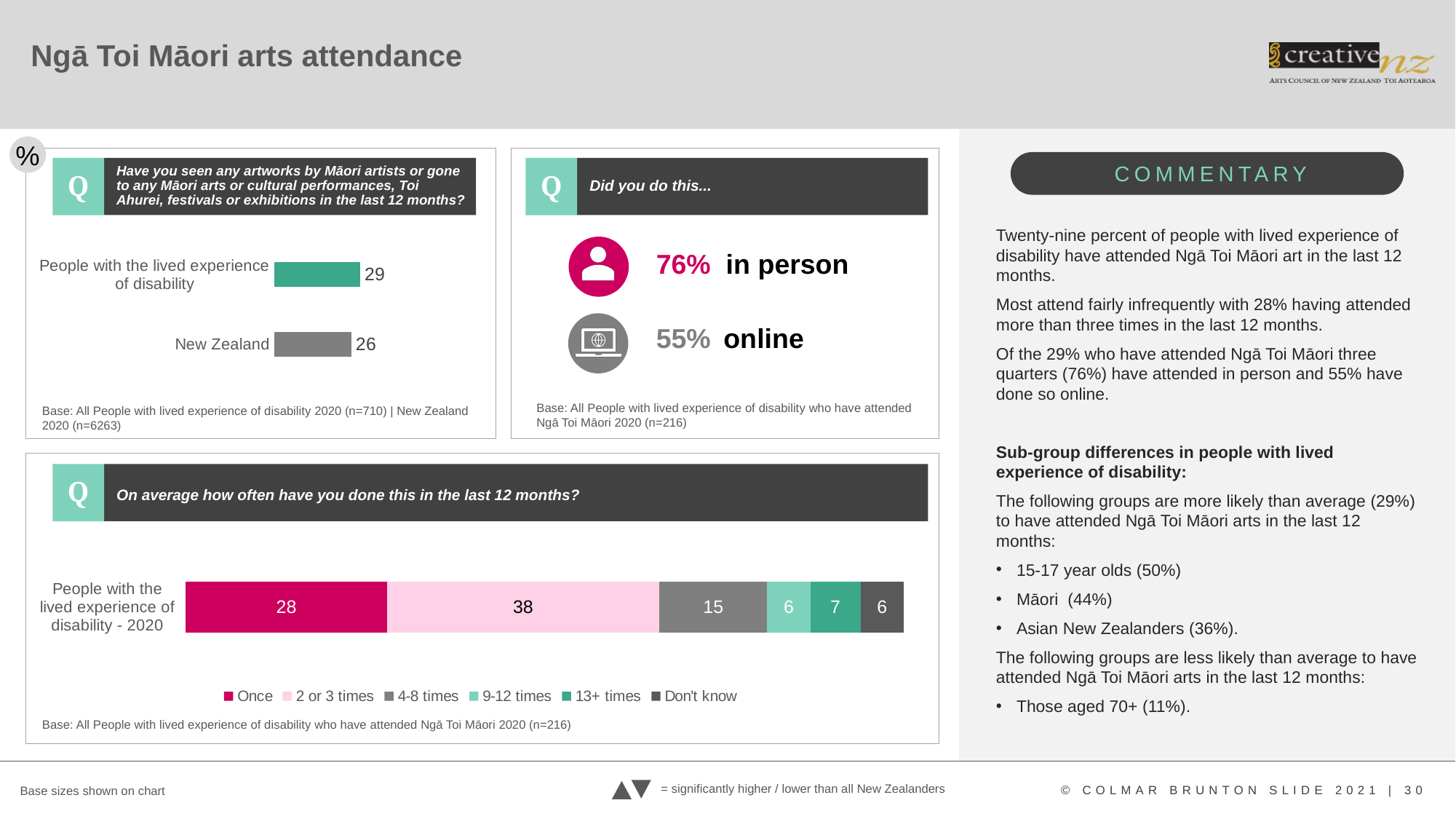
In the bottom stacked bar chart on how often people have done this in the last 12 months, what is the value for Once? 28 In the top-left chart on attendance in the last 12 months, which category has the higher value? People with the lived experience of disability In the top-left chart on attendance in the last 12 months, what is the value for People with the lived experience of disability? 29 In the top-left chart on attendance in the last 12 months, what is the value for New Zealand? 26 What kind of chart is the top-left chart on attendance in the last 12 months? Bar chart In the bottom stacked bar chart on how often people have done this in the last 12 months, what is the value for 2 or 3 times? 38 In the bottom stacked bar chart on how often people have done this in the last 12 months, what is the total of all segments in the bar? 100 In the top-left chart on attendance in the last 12 months, how many categories are shown? 2 In the top-left chart on attendance in the last 12 months, what is the difference between the value for People with the lived experience of disability and the value for New Zealand? 3 In the bottom stacked bar chart on how often people have done this in the last 12 months, how many series does the legend list? 6 In the bottom stacked bar chart on how often people have done this in the last 12 months, which segment is the largest? 2 or 3 times In the bottom stacked bar chart on how often people have done this in the last 12 months, what is the value for 4-8 times? 15